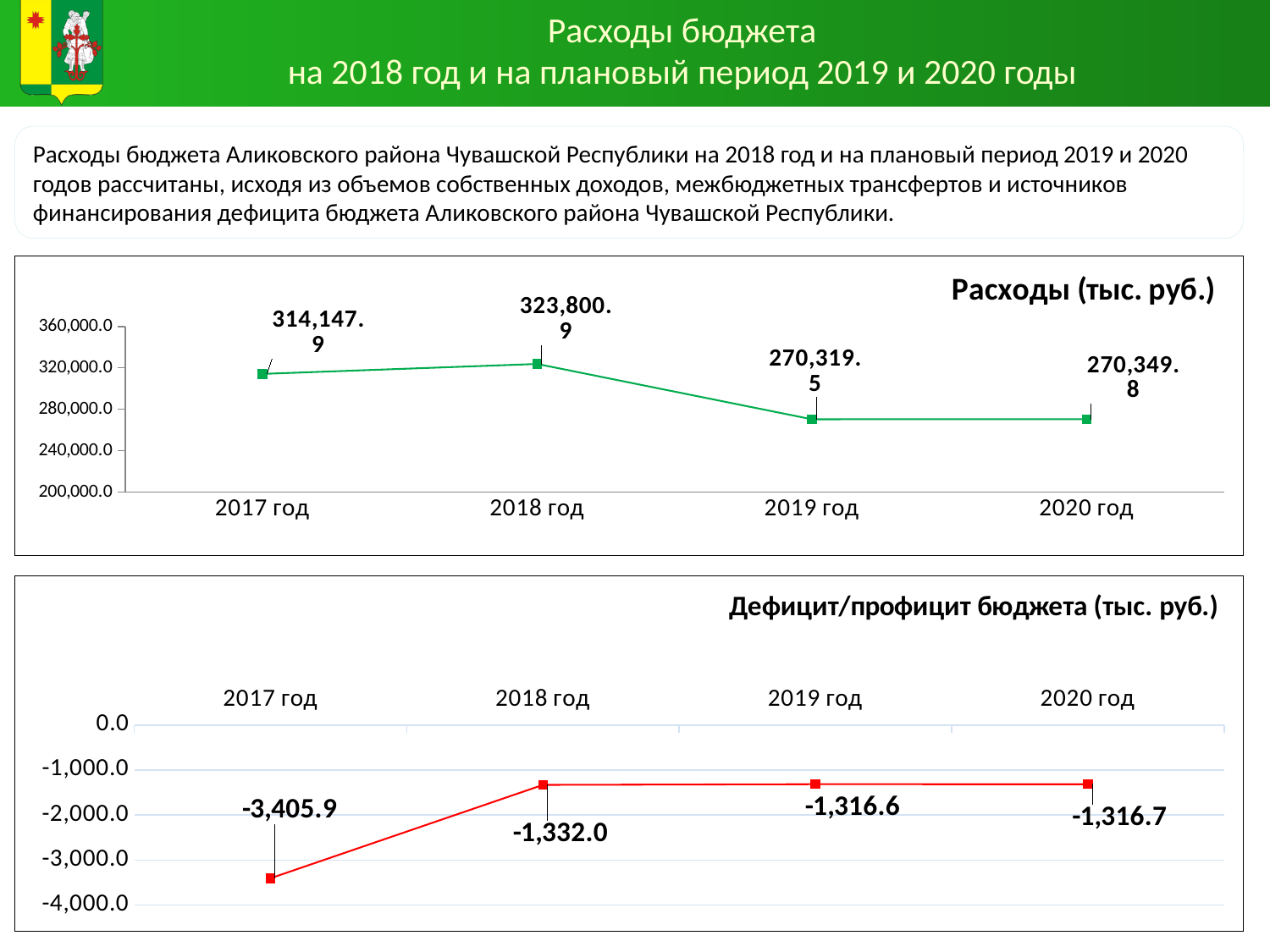
In the chart titled 'Расходы (тыс. руб.)', what is the value for 2018 год? 323,800.9 In the chart titled 'Дефицит/профицит бюджета (тыс. руб.)', what is the value for 2017 год? -3,405.9 In the chart titled 'Расходы (тыс. руб.)', is the value for 2019 год greater or less than 280,000.0? less In the chart titled 'Дефицит/профицит бюджета (тыс. руб.)', what is the difference between the values for 2018 год and 2017 год? 2,073.9 In the chart titled 'Расходы (тыс. руб.)', does the value rise or fall from 2018 год to 2019 год? fall In the chart titled 'Расходы (тыс. руб.)', which year has the highest value? 2018 год In the chart titled 'Дефицит/профицит бюджета (тыс. руб.)', what is the value for 2019 год? -1,316.6 In the chart titled 'Расходы (тыс. руб.)', what is the value for 2020 год? 270,349.8 In the chart titled 'Дефицит/профицит бюджета (тыс. руб.)', which year has the lowest value? 2017 год In the chart titled 'Расходы (тыс. руб.)', what is the difference between the values for 2018 год and 2017 год? 9,653.0 In the chart titled 'Расходы (тыс. руб.)', how many years are plotted? 4 What type of chart is the chart titled 'Дефицит/профицит бюджета (тыс. руб.)'? line chart